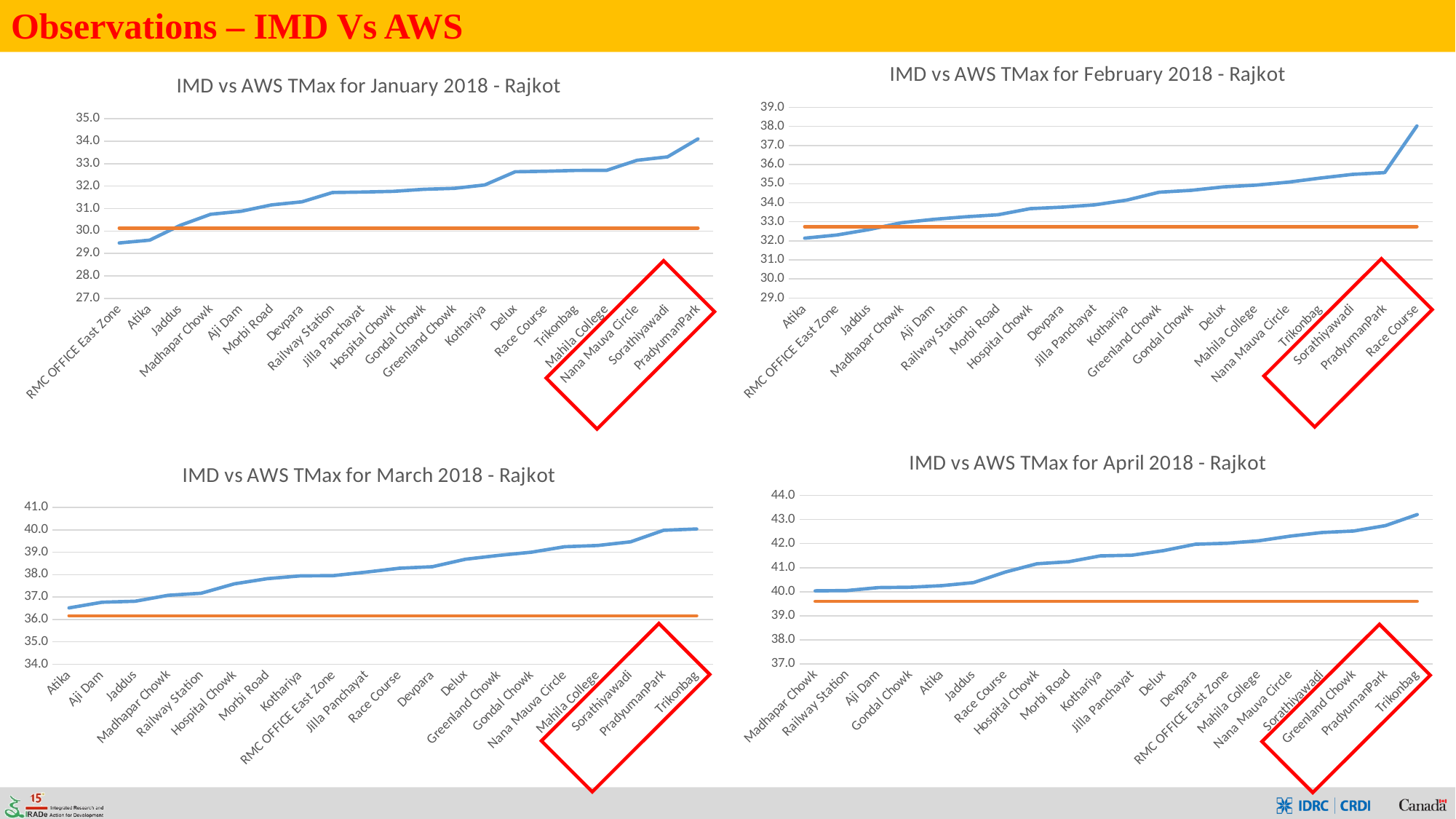
In the 'IMD vs AWS TMax for April 2018 - Rajkot' chart, is the blue line value for Madhapar Chowk greater or less than 41.0? less What kind of chart is the 'IMD vs AWS TMax for January 2018 - Rajkot' chart? line chart In the 'IMD vs AWS TMax for January 2018 - Rajkot' chart, how many locations are plotted along the x axis? 20 In the 'IMD vs AWS TMax for January 2018 - Rajkot' chart, which location has the lowest value on the blue line? RMC OFFICE East Zone What is the title of the bottom-left chart on the slide? IMD vs AWS TMax for March 2018 - Rajkot In the 'IMD vs AWS TMax for March 2018 - Rajkot' chart, does the blue line rise or fall from left to right? rise In the 'IMD vs AWS TMax for April 2018 - Rajkot' chart, which has the larger blue line value, Madhapar Chowk or Trikonbag? Trikonbag In the 'IMD vs AWS TMax for February 2018 - Rajkot' chart, which location has the highest value on the blue line? Race Course In the 'IMD vs AWS TMax for January 2018 - Rajkot' chart, is the blue line value for Atika greater or less than 30.0? less In the 'IMD vs AWS TMax for April 2018 - Rajkot' chart, which location has the highest value on the blue line? Trikonbag In the 'IMD vs AWS TMax for February 2018 - Rajkot' chart, is the blue line value for Race Course greater or less than 37.0? greater In the 'IMD vs AWS TMax for March 2018 - Rajkot' chart, which location has the lowest value on the blue line? Atika